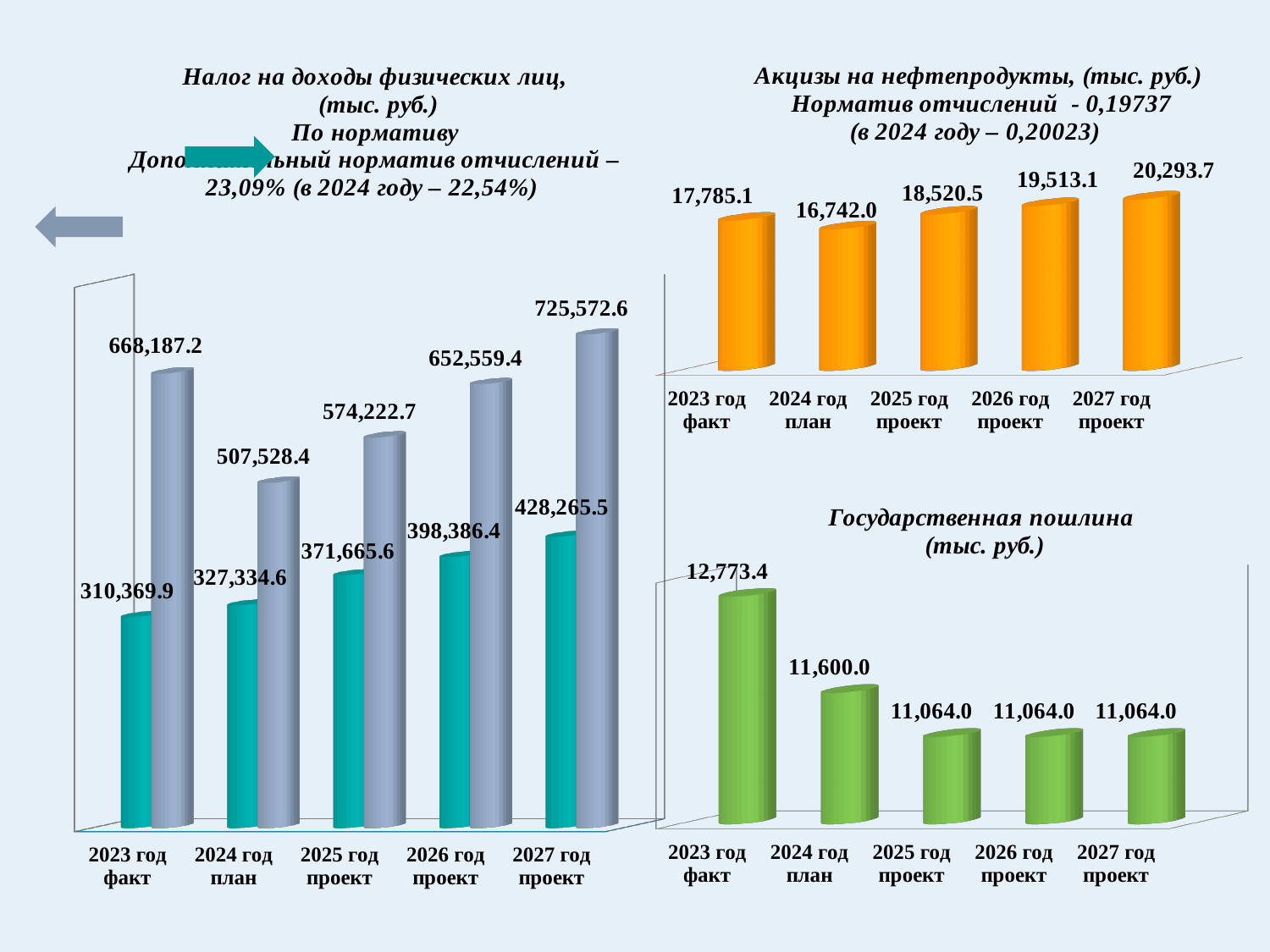
What kind of chart is the 'Государственная пошлина' chart? bar chart In the 'Налог на доходы физических лиц' chart, what is the value of the grey bar for 2027 год проект? 725,572.6 In the 'Акцизы на нефтепродукты' chart, which year has the highest value? 2027 год проект In the 'Государственная пошлина' chart, what is the value for 2023 год факт? 12,773.4 In the 'Акцизы на нефтепродукты' chart, what is the value for 2024 год план? 16,742.0 In the 'Государственная пошлина' chart, how many categories are shown on the x axis? 5 In the 'Акцизы на нефтепродукты' chart, what is the difference between the 2027 год проект value and the 2023 год факт value? 2,508.6 In the 'Налог на доходы физических лиц' chart, which year has the lowest grey bar value? 2024 год план In the 'Налог на доходы физических лиц' chart, what is the value of the teal bar for 2025 год проект? 371,665.6 In the 'Государственная пошлина' chart, do the values rise or fall from 2023 год факт to 2025 год проект? fall In the 'Налог на доходы физических лиц' chart, which is larger for 2023 год факт: the teal bar or the grey bar? the grey bar In the 'Государственная пошлина' chart, what is the difference between the 2023 год факт value and the 2024 год план value? 1,173.4